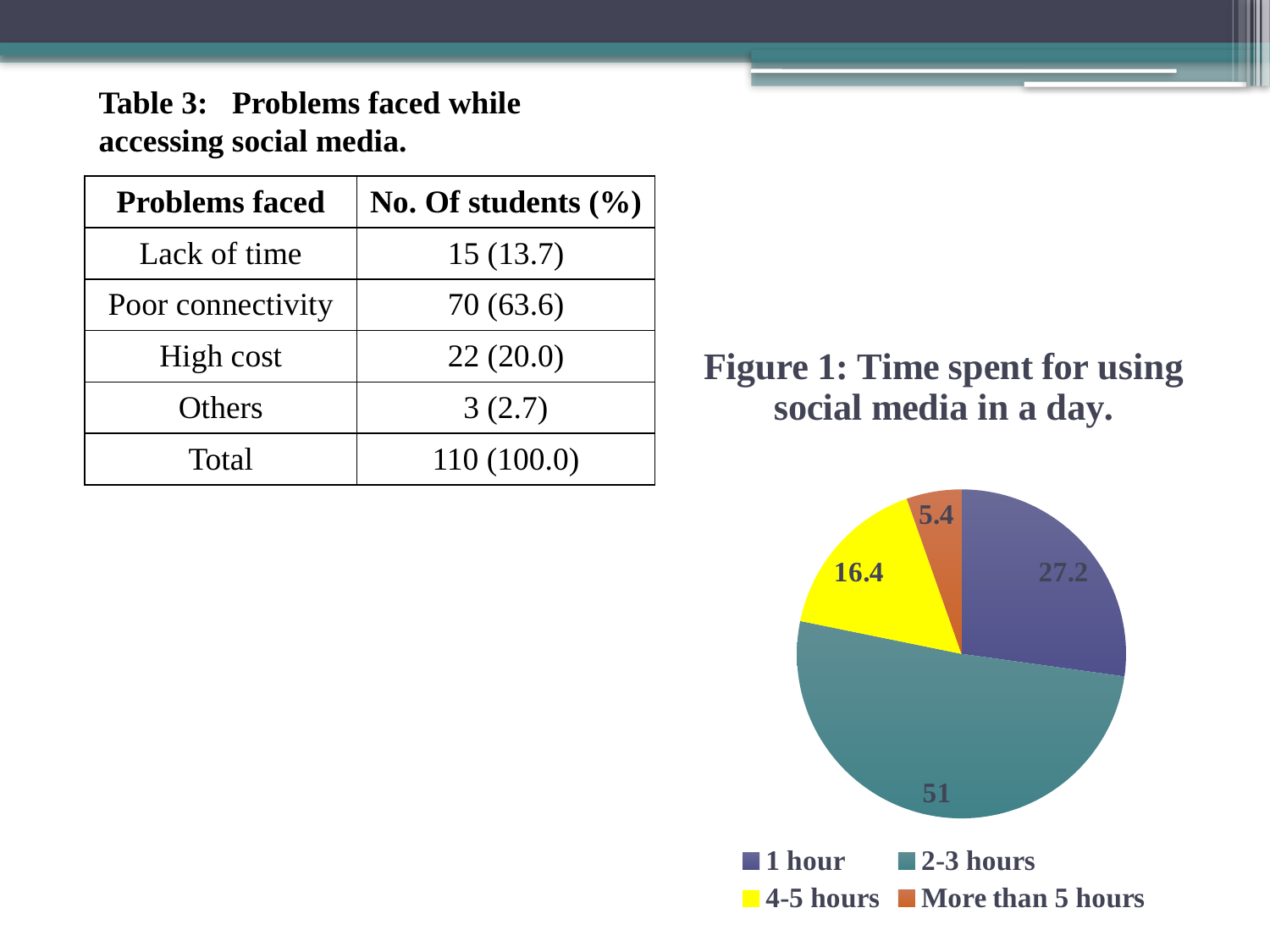
Which category has the largest slice in the pie chart? 2-3 hours In the pie chart, what is the value for the More than 5 hours slice? 5.4 In the pie chart, what is the value for the 1 hour slice? 27.2 In the pie chart, what is the value for the 4-5 hours slice? 16.4 In the pie chart, what is the difference between the values for 2-3 hours and 1 hour? 23.8 What is the title of the pie chart? Figure 1: Time spent for using social media in a day. Which category has the smallest slice in the pie chart? More than 5 hours How many categories does the pie chart show? 4 What kind of chart is shown in Figure 1? Pie chart In the pie chart, which category is shown in yellow? 4-5 hours In the pie chart, what is the value for the 2-3 hours slice? 51 In the pie chart, which is larger: the value for 1 hour or the value for 4-5 hours? 1 hour